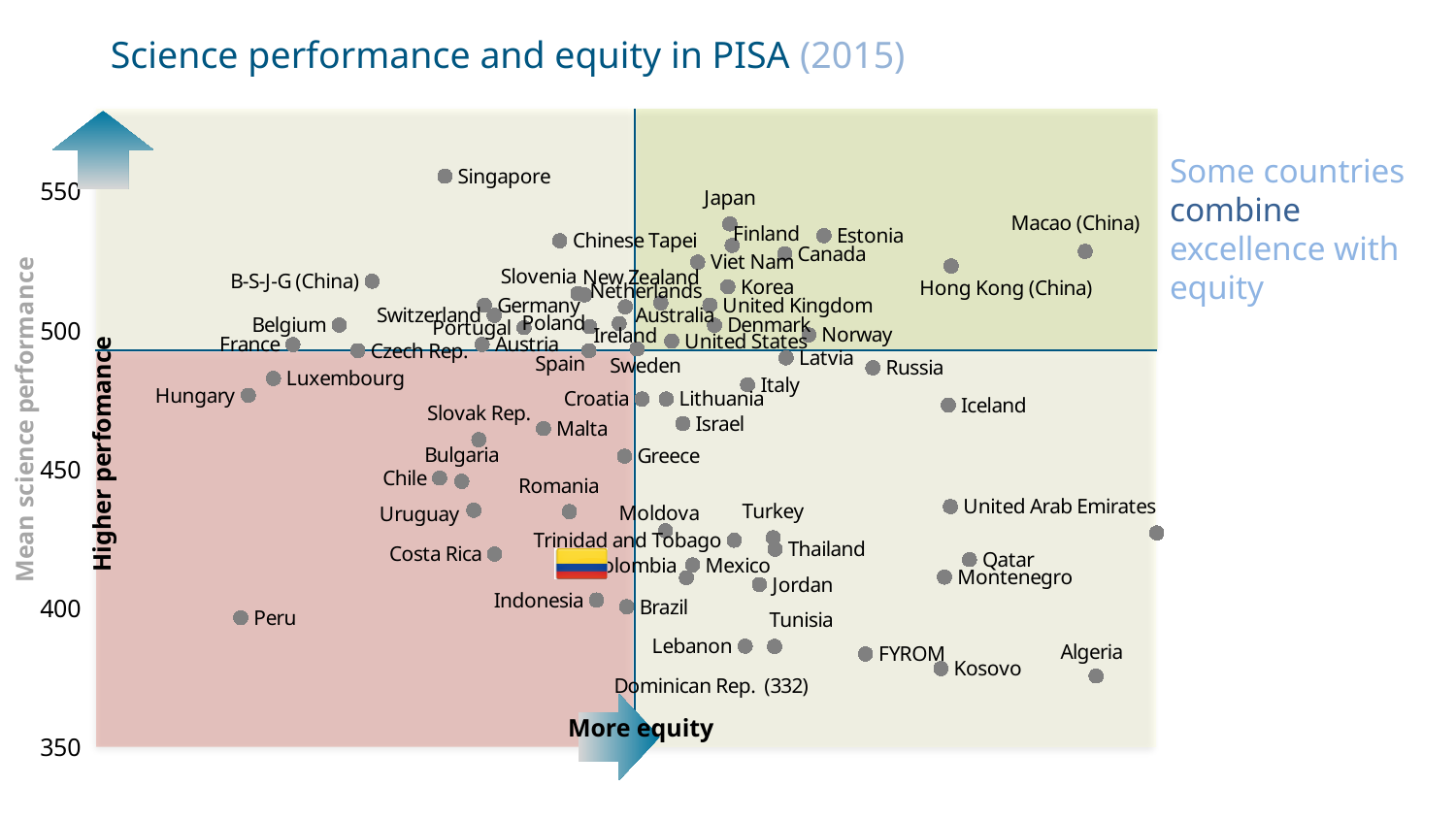
Is the mean science performance for Singapore greater or less than 550? greater Which country has the highest mean science performance on the chart? Singapore Is the mean science performance for Algeria greater or less than 400? less Which has a higher mean science performance, Singapore or Peru? Singapore What is the label of the vertical axis of the chart? Mean science performance Is the mean science performance for Japan greater or less than 500? greater Which has a higher mean science performance, Macao (China) or Brazil? Macao (China) What kind of chart is shown on the slide? scatter chart What mean science performance value is printed for Dominican Rep.? 332